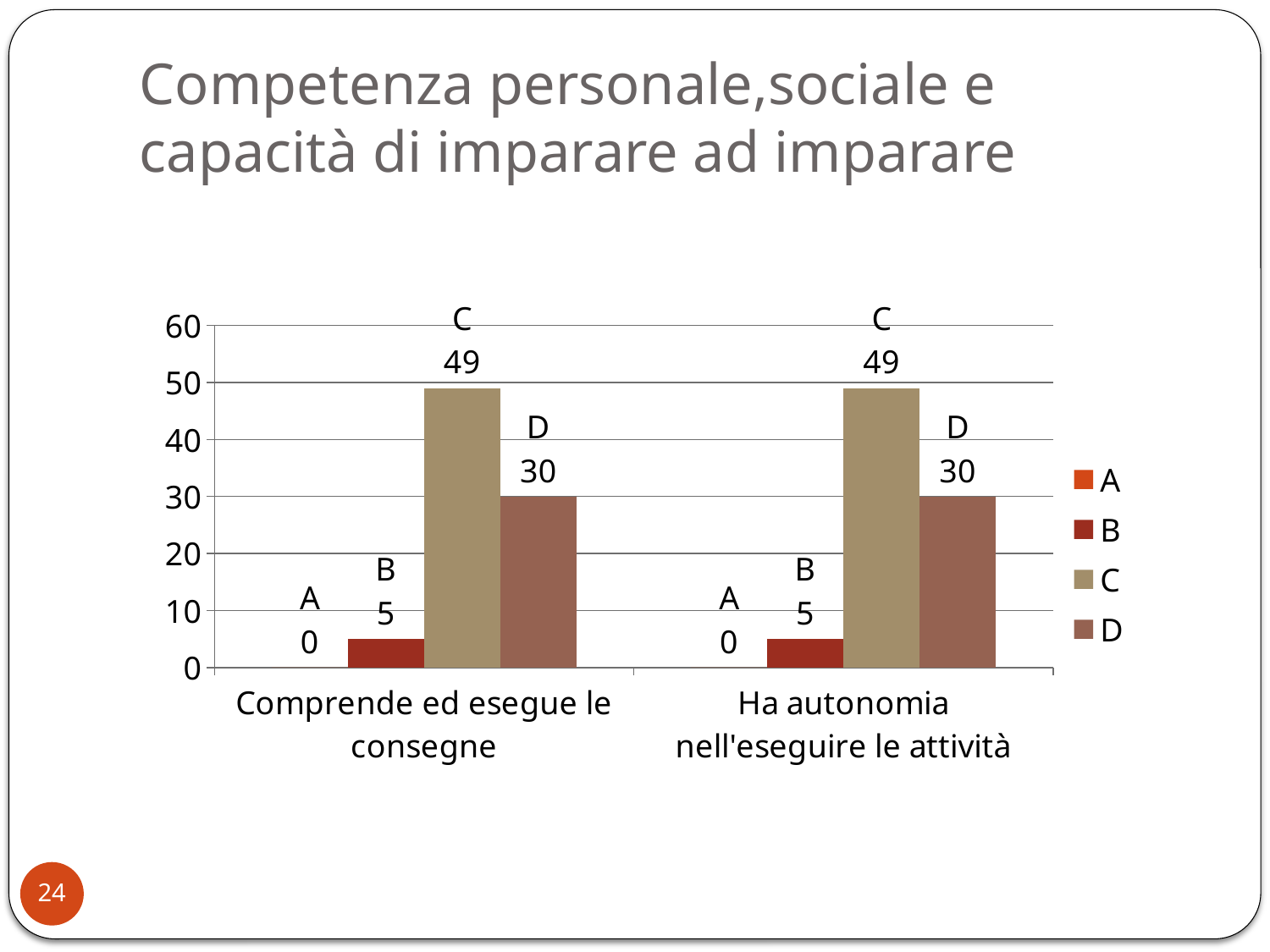
Which series has the lowest value in the category "Comprende ed esegue le consegne"? A What is the value for series C in the category "Comprende ed esegue le consegne"? 49 What is the difference between the values for series C and series D in the category "Comprende ed esegue le consegne"? 19 What kind of chart is shown on the slide? Bar chart What is the highest value shown on the vertical axis? 60 In the category "Ha autonomia nell'eseguire le attività", which is larger: the value for series B or the value for series D? D Which series has the highest value in the category "Ha autonomia nell'eseguire le attività"? C How many series does the legend list? 4 What is the value for series D in the category "Ha autonomia nell'eseguire le attività"? 30 What is the value for series A in the category "Ha autonomia nell'eseguire le attività"? 0 How many categories are shown on the x axis? 2 What is the value for series B in the category "Comprende ed esegue le consegne"? 5